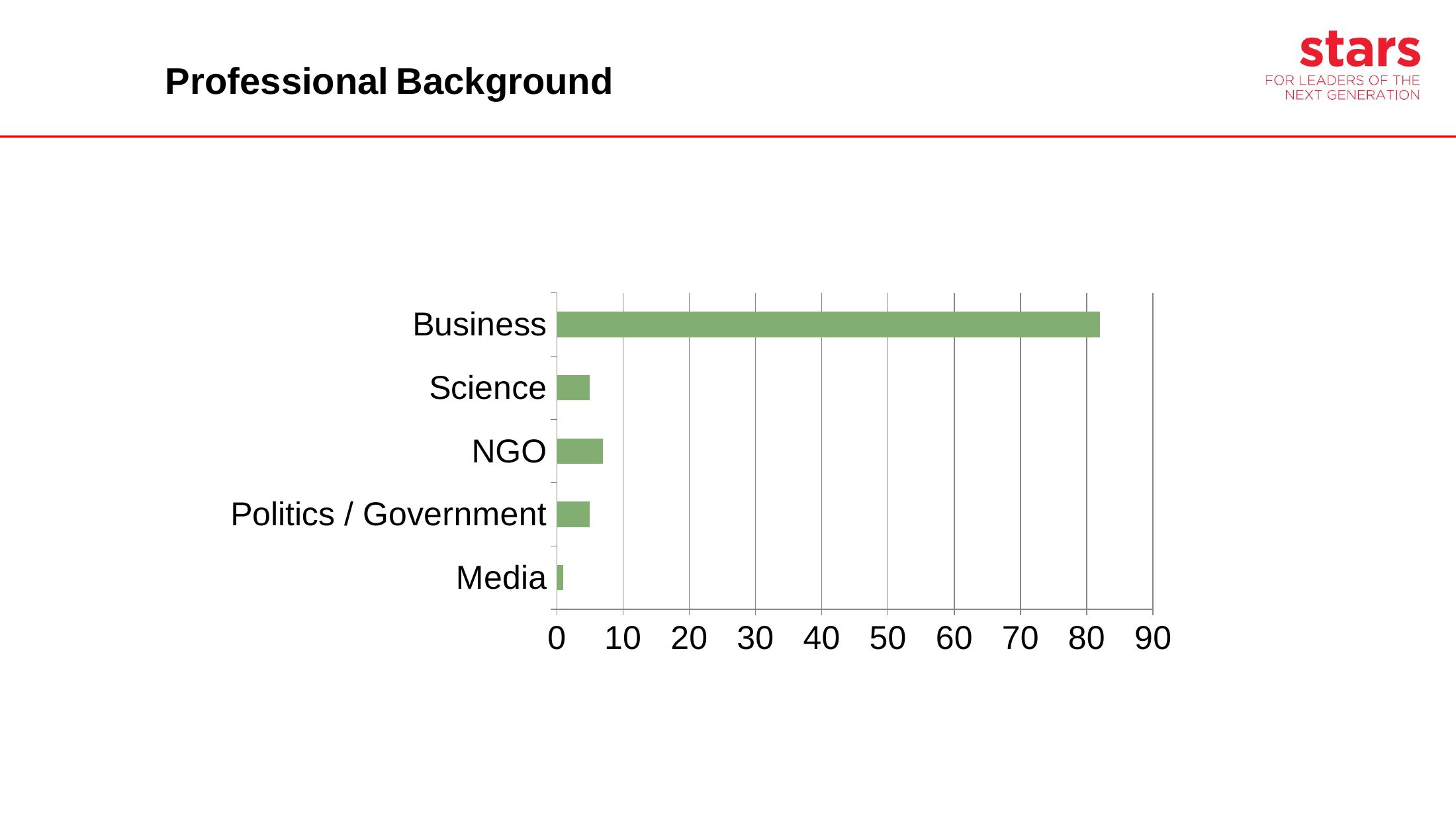
Is the value for Business greater or less than 80? greater Is the value for Business greater or less than 90? less Which category has the lowest value? Media How many categories are shown in the chart? 5 Is the value for Science greater or less than 10? less What is the title of the slide containing the chart? Professional Background What colour are the bars in the chart? green What kind of chart is shown on the slide? bar chart Which is larger, the value for NGO or the value for Media? NGO Which is larger, the value for Business or the value for Science? Business Which category has the highest value? Business